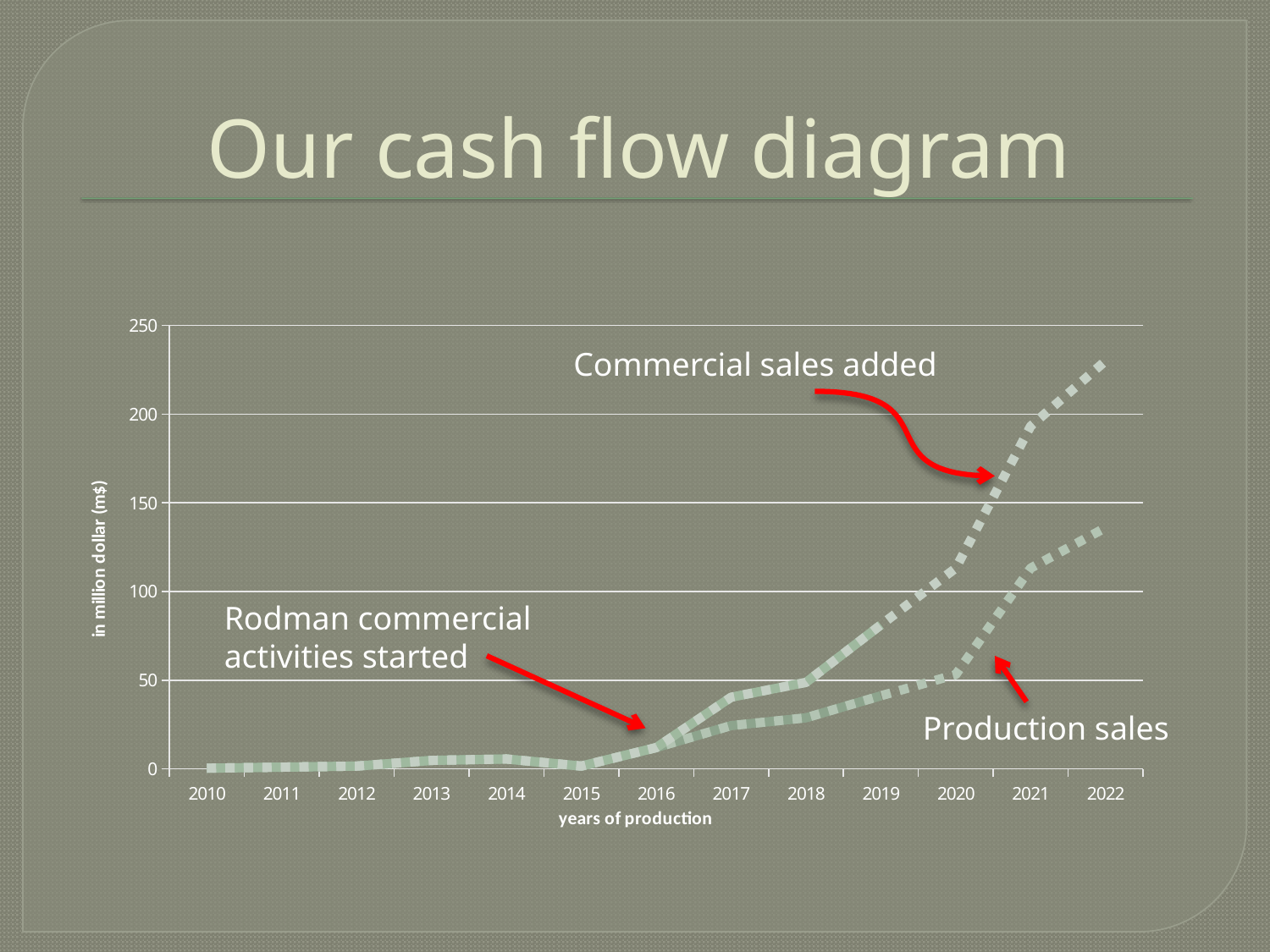
Is the value of the Production sales line in 2022 greater or less than 100? greater What is the title of the chart on the slide? Our cash flow diagram What is the label of the y axis? in million dollar (m$) Do the values of the Commercial sales line rise or fall from 2016 to 2022? rise Is the value of the Commercial sales line in 2022 greater or less than 200? greater What kind of chart is shown on the slide? line chart Is the value of the Commercial sales line in 2021 greater or less than 150? greater How many years are plotted along the x axis? 13 In 2022, which line is higher: Commercial sales or Production sales? Commercial sales